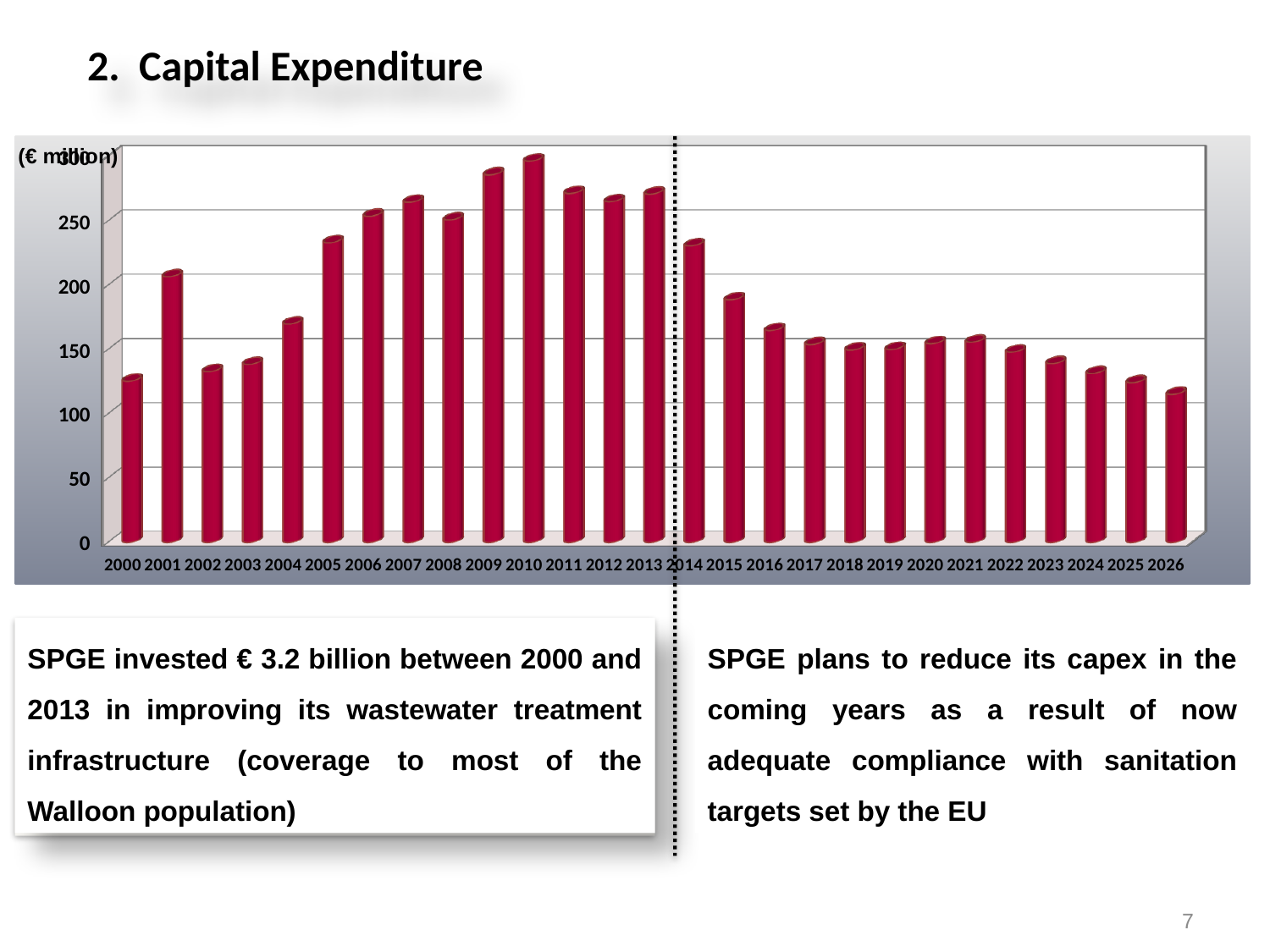
Do the values rise or fall from 2014 to 2026? Fall Is the value for 2000 greater or less than 150? less In what unit are the values on the chart's vertical axis expressed? € million Is the value for 2010 greater or less than 250? greater Is the value for 2026 greater or less than 150? less What kind of chart is shown on the slide? Bar chart How many years are shown on the x axis of the chart? 27 Which year has the lowest capital expenditure in the chart? 2026 Which year has the highest capital expenditure in the chart? 2010 Which year has the larger value, 2001 or 2002? 2001